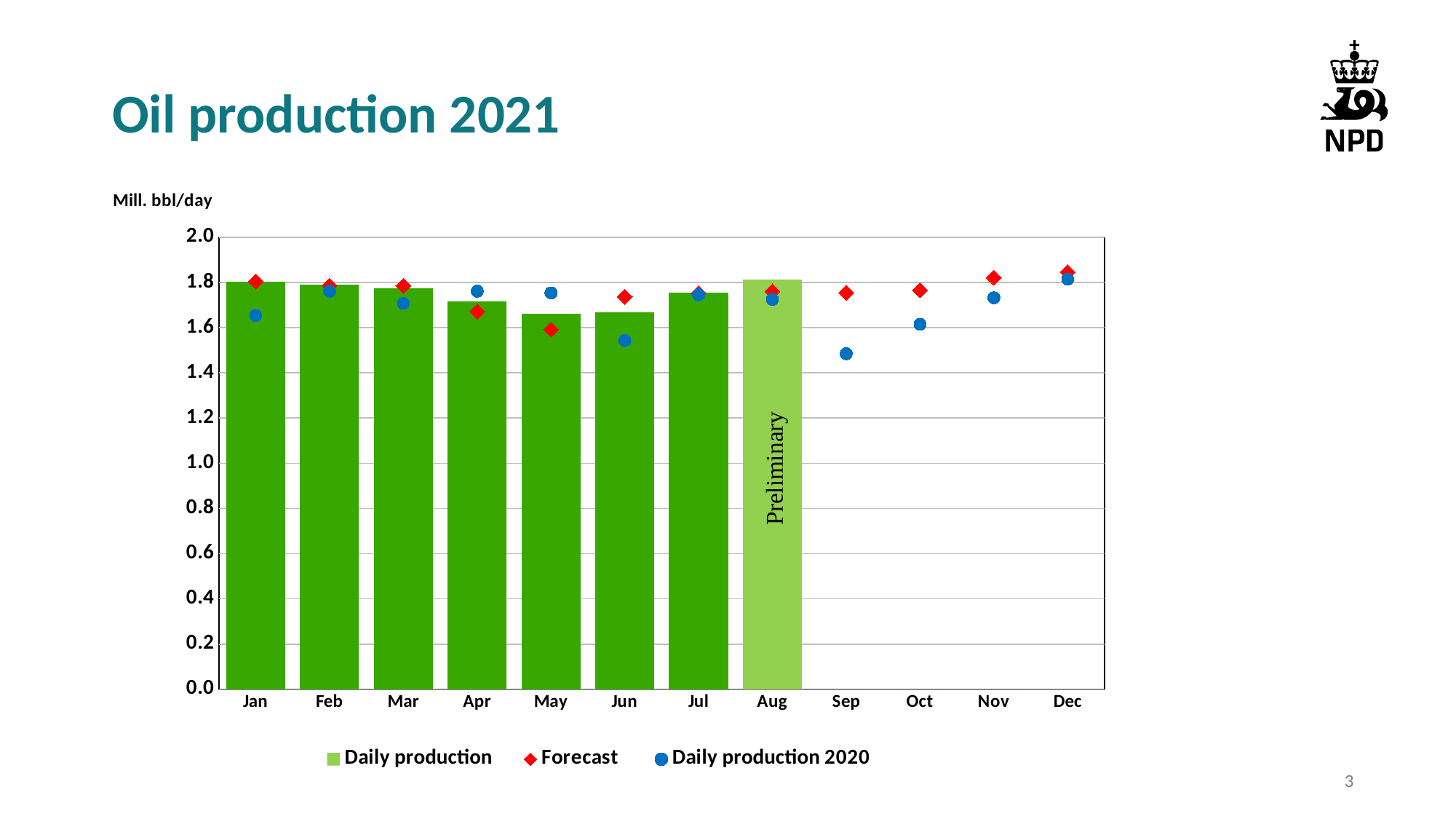
Which month's bar is labelled 'Preliminary'? Aug In Jan, which is larger: the Daily production bar or the Daily production 2020 point? Daily production How many series does the legend list? 3 How many months have a Daily production bar? 8 Which month has the lowest Forecast value? May What kind of chart is shown on the slide? bar chart Is the Daily production value for Jan greater or less than 1.6? greater Is the Forecast value for Dec greater or less than 1.8? greater Is the Daily production 2020 value for Sep greater or less than 1.6? less What unit is given for the y axis? Mill. bbl/day How many months are shown on the x axis? 12 Which month has the lowest Daily production 2020 value? Sep